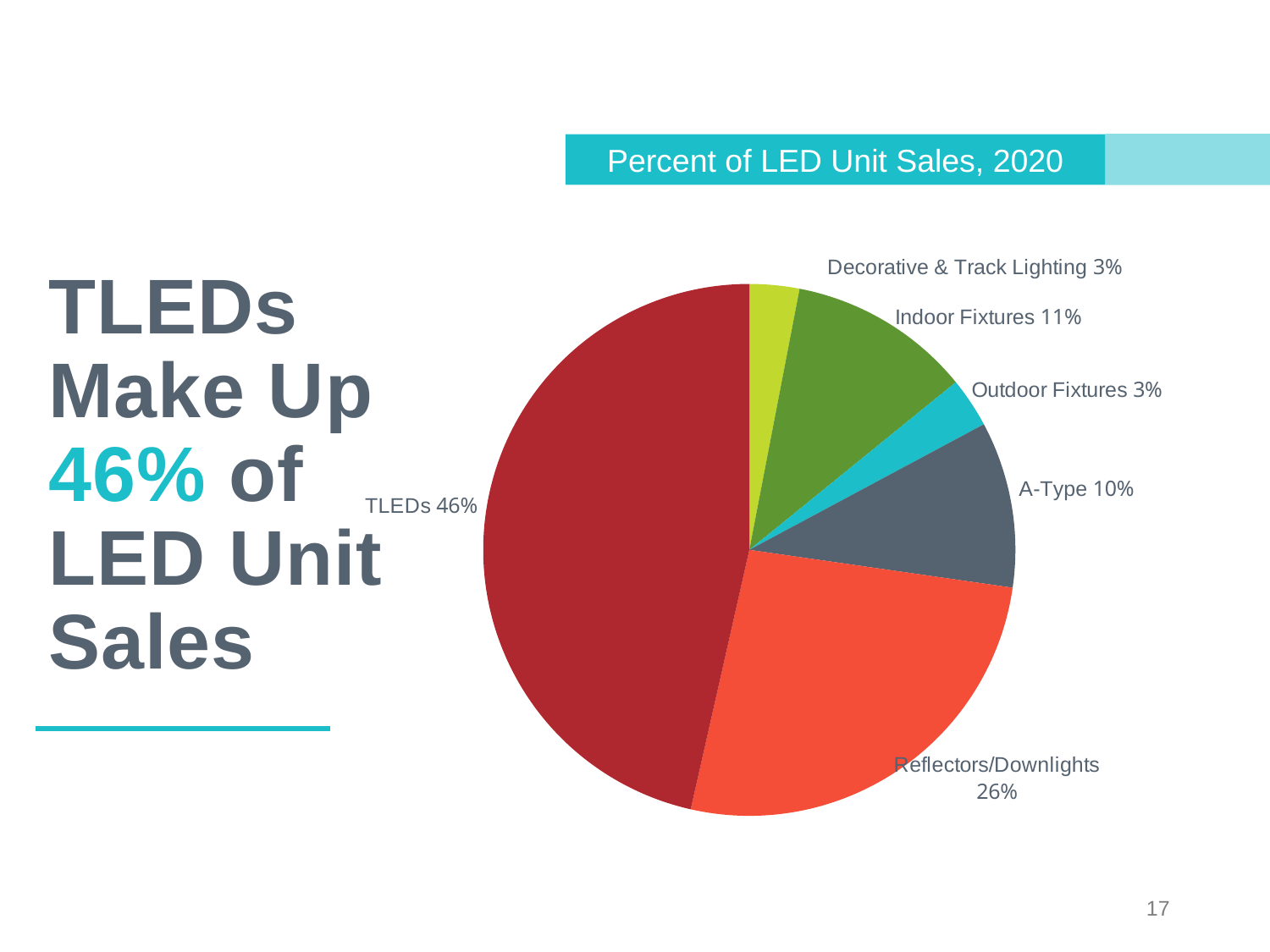
What share of LED unit sales do TLEDs make up? 46% What type of chart is shown on the slide? pie chart What share of LED unit sales do Outdoor Fixtures make up? 3% Which has a larger share, Indoor Fixtures or A-Type? Indoor Fixtures What share of LED unit sales do Reflectors/Downlights make up? 26% How many categories are shown in the pie chart? 6 Which category has the largest share of LED unit sales? TLEDs What colour is the TLEDs slice? dark red What share of LED unit sales do Indoor Fixtures make up? 11% What is the title of the chart? Percent of LED Unit Sales, 2020 What is the difference in share between TLEDs and Reflectors/Downlights? 20 percentage points What share of LED unit sales does A-Type make up? 10%